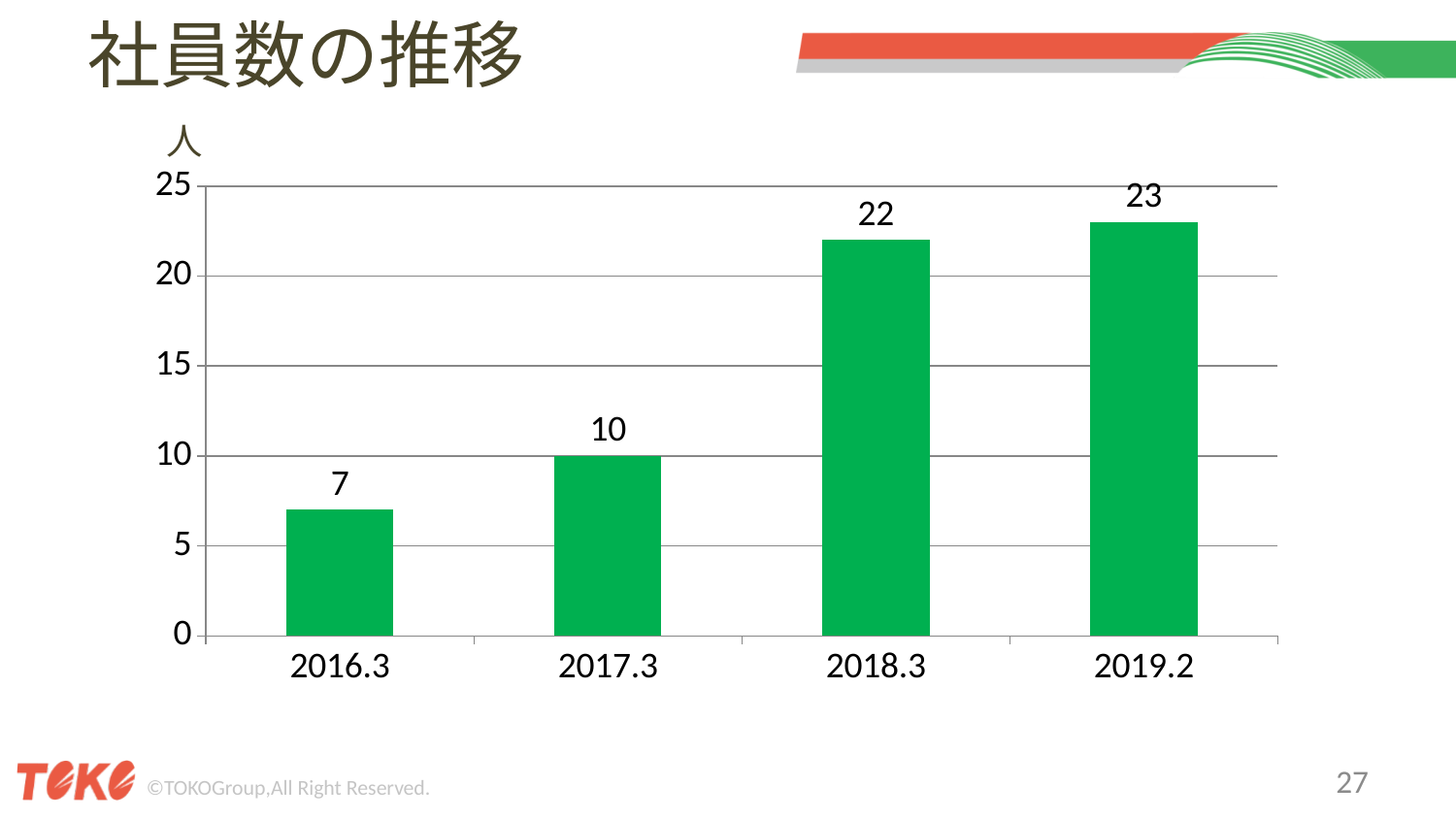
Do the values rise or fall from 2016.3 to 2019.2? Rise What kind of chart is shown on the slide? Bar chart What is the value for 2017.3? 10 Which category has the lowest value? 2016.3 What is the difference between the values for 2018.3 and 2017.3? 12 What is the value for 2016.3? 7 What is the value for 2018.3? 22 Which category has the highest value? 2019.2 How many categories are shown on the x axis? 4 Which is larger, the value for 2017.3 or the value for 2016.3? 2017.3 What is the value for 2019.2? 23 What is the title of the chart? 社員数の推移